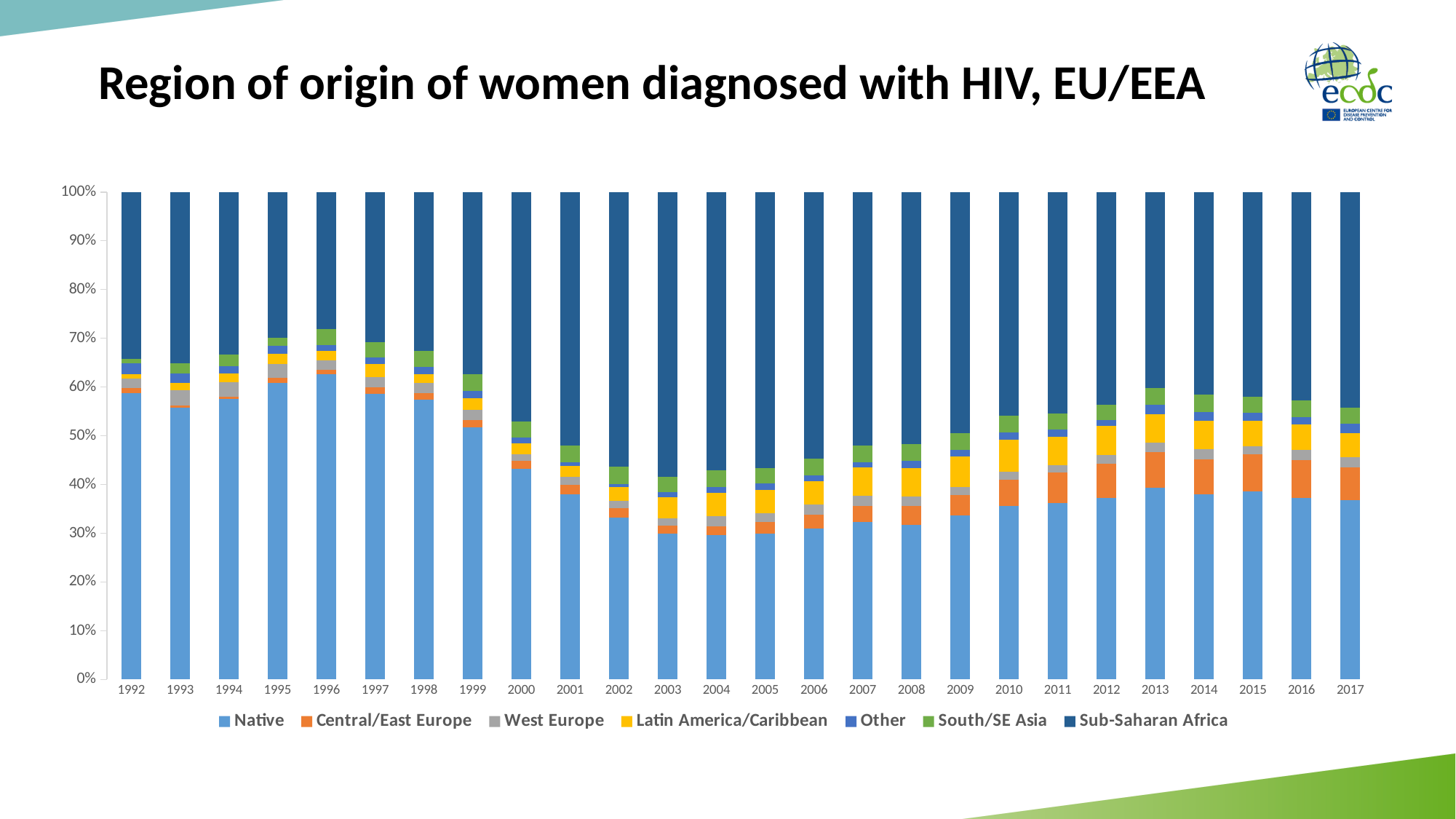
Is the Native share in 2003 greater or less than 40%? less What is the title of the chart? Region of origin of women diagnosed with HIV, EU/EEA How many years (bars) are shown on the x axis? 26 Which series is plotted at the top of each stacked bar? Sub-Saharan Africa Does the Native share rise or fall from 1992 to 2003? fall How many series does the legend list? 7 Is the Native share in 1996 greater or less than 60%? greater Is the Native share in 1992 greater or less than 50%? greater What is the total height of each stacked bar? 100% What kind of chart is shown on the slide? Stacked bar chart Which year has the larger Native share, 1996 or 2003? 1996